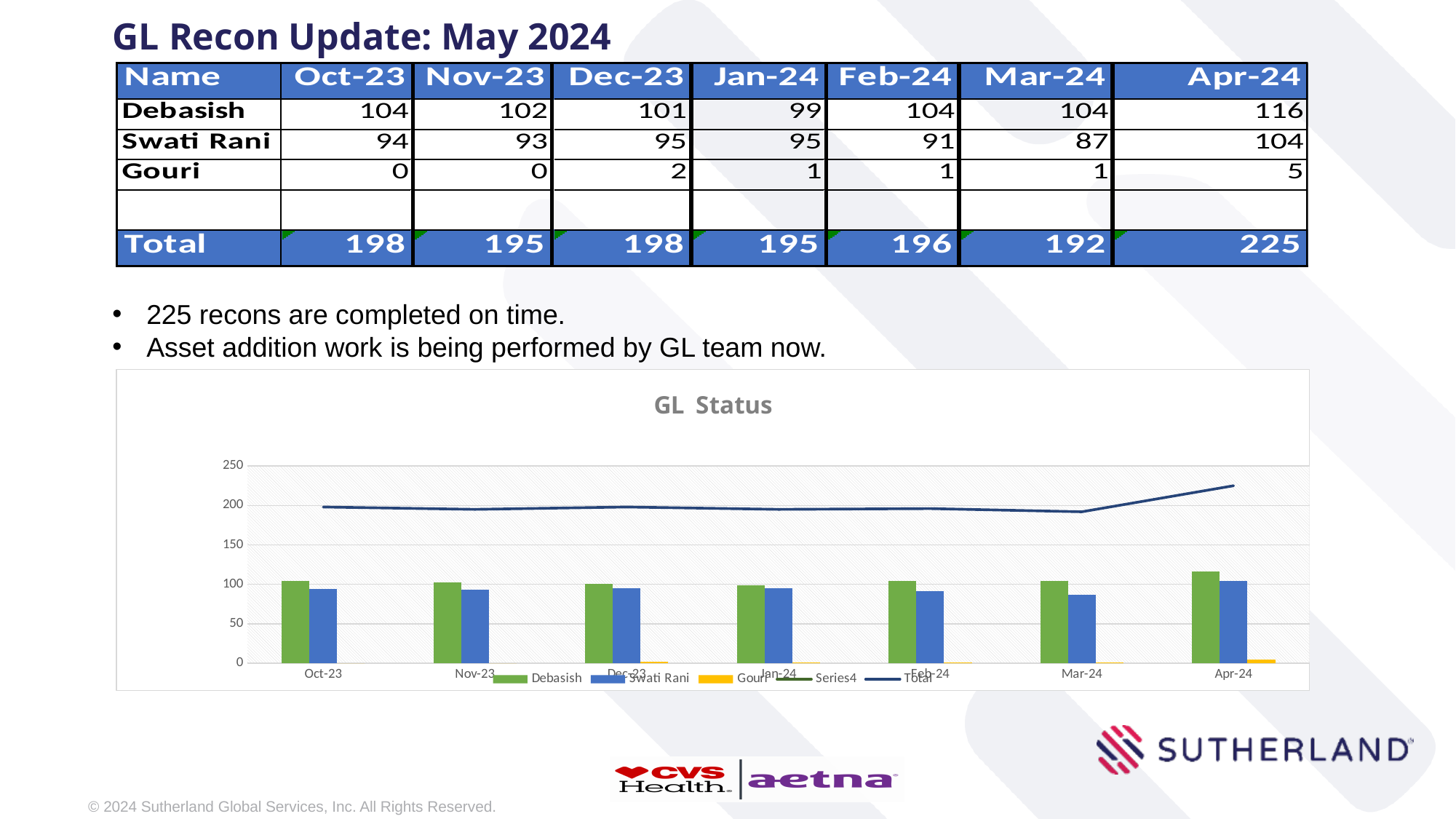
Is the Total value for Mar-24 greater or less than 200? less What kind of chart is shown on the slide? Combined bar and line chart Is the Total value for Apr-24 greater or less than 200? greater What colour are the Debasish bars in the chart? Green How many entries does the chart legend list? 5 What is the title of the chart? GL Status Which month has the highest Total value on the line in the chart? Apr-24 Is the Swati Rani bar for Mar-24 greater or less than 100? less Which series has the lowest bars across all months in the chart? Gouri In Apr-24, which bar is taller, Debasish or Swati Rani? Debasish How many months are shown along the x axis of the chart? 7